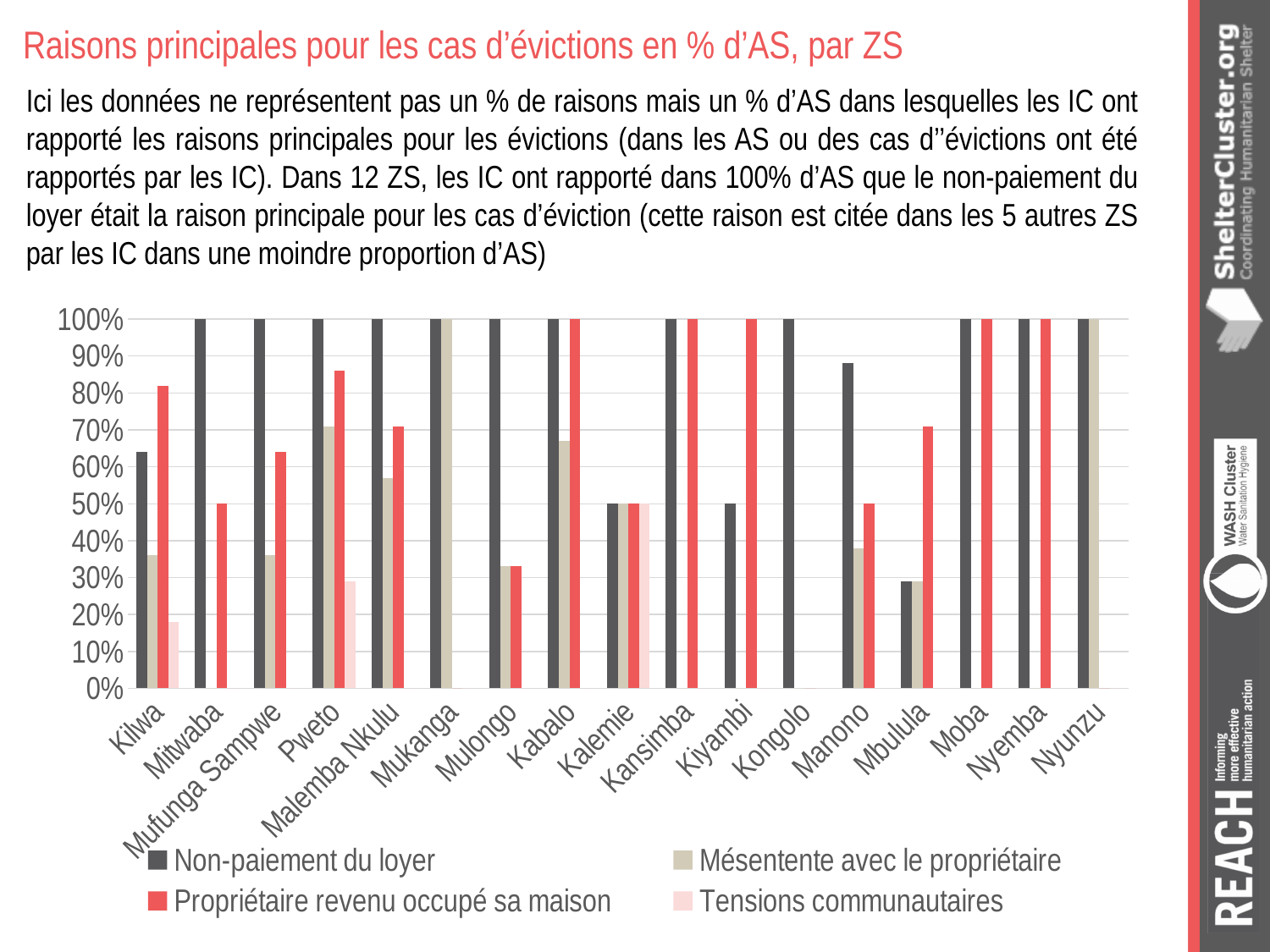
How many zones de santé (categories) are shown on the x axis? 17 Which is larger for Mbulula: 'Non-paiement du loyer' or 'Propriétaire revenu occupé sa maison'? Propriétaire revenu occupé sa maison What kind of chart is shown on the slide? bar chart What is the value of 'Propriétaire revenu occupé sa maison' for Kiyambi? 100% Is the value of 'Mésentente avec le propriétaire' for Mulongo greater or less than 40%? less Which series is shown in dark grey in the legend? Non-paiement du loyer How many series does the legend list? 4 What is the value of 'Propriétaire revenu occupé sa maison' for Mitwaba? 50% Is the value of 'Propriétaire revenu occupé sa maison' for Pweto greater or less than 80%? greater What is the value of 'Non-paiement du loyer' for Kalemie? 50% What is the value of 'Mésentente avec le propriétaire' for Mukanga? 100% Is the value of 'Non-paiement du loyer' for Manono greater or less than 80%? greater